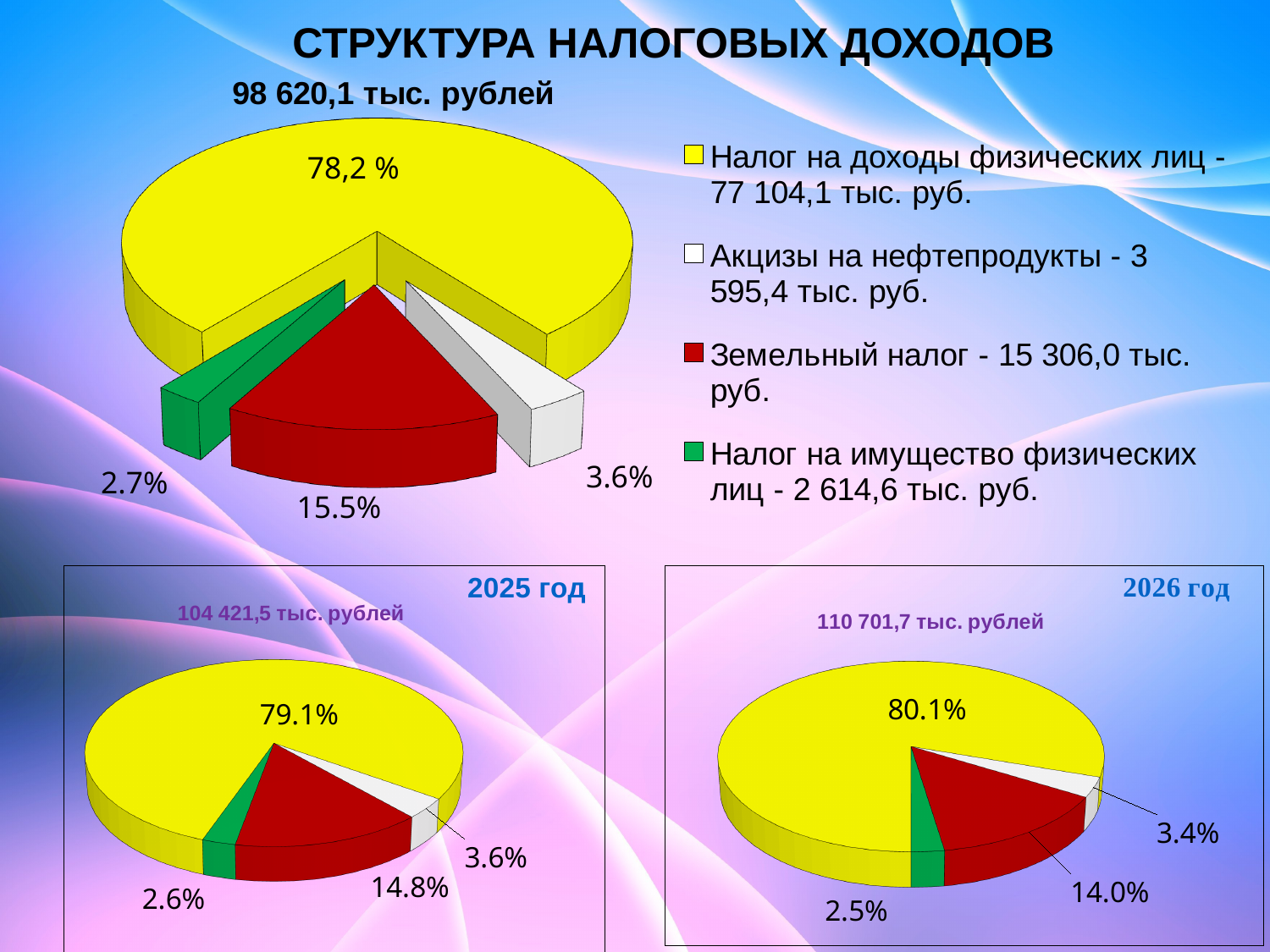
What total amount is shown above the bottom-right pie chart (2026 год)? 110 701,7 тыс. рублей How many categories does the legend of the top chart list? 4 According to the legend of the top chart, what is the value for Акцизы на нефтепродукты? 3 595,4 тыс. руб. According to the legend of the top chart, what is the value for Земельный налог? 15 306,0 тыс. руб. In the top pie chart, what share does the red slice (Земельный налог) have? 15.5% In the top pie chart, which category has the smallest share? Налог на имущество физических лиц In the bottom-left pie chart (2025 год), what is the share of the largest slice? 79.1% In the top pie chart, what share does the green slice (Налог на имущество физических лиц) have? 2.7% Which is larger: the red slice share in the 2025 год chart or the red slice share in the 2026 год chart? 2025 год (14.8%) In the bottom-right pie chart (2026 год), what is the share of the red slice? 14.0% What kind of chart is the top chart on the slide? pie chart